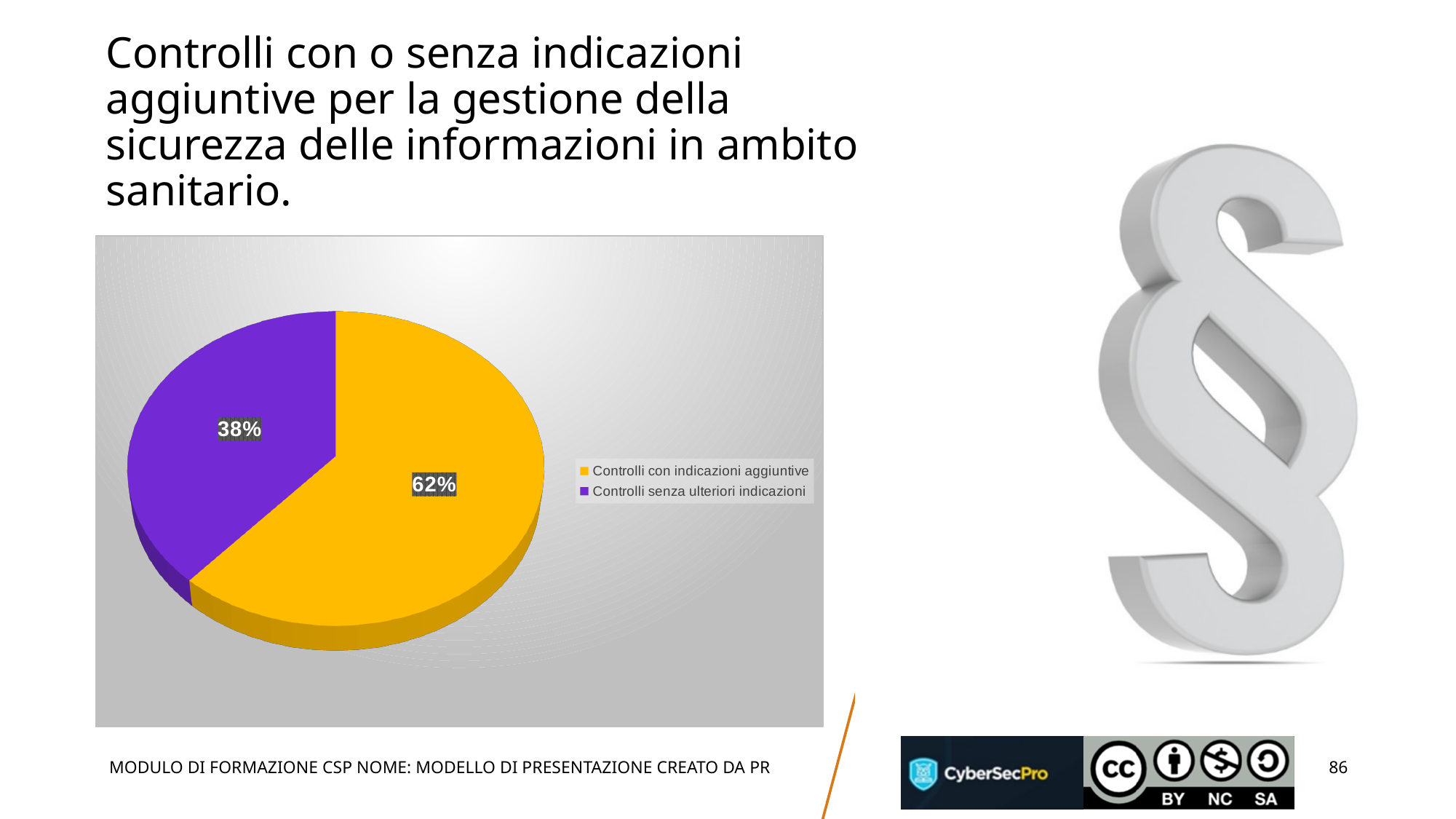
How many slices does the pie chart have? 2 What colour is the 'Controlli senza ulteriori indicazioni' slice? purple Which slice of the pie is the largest? Controlli con indicazioni aggiuntive What share of the pie is 'Controlli senza ulteriori indicazioni'? 38% What kind of chart is shown on the slide? pie chart Which slice of the pie is the smallest? Controlli senza ulteriori indicazioni Which is larger: the 'Controlli con indicazioni aggiuntive' slice or the 'Controlli senza ulteriori indicazioni' slice? Controlli con indicazioni aggiuntive What colour is the 'Controlli con indicazioni aggiuntive' slice? yellow How many entries does the legend list? 2 What is the difference in percentage points between the 'Controlli con indicazioni aggiuntive' slice and the 'Controlli senza ulteriori indicazioni' slice? 24 What share of the pie is 'Controlli con indicazioni aggiuntive'? 62%